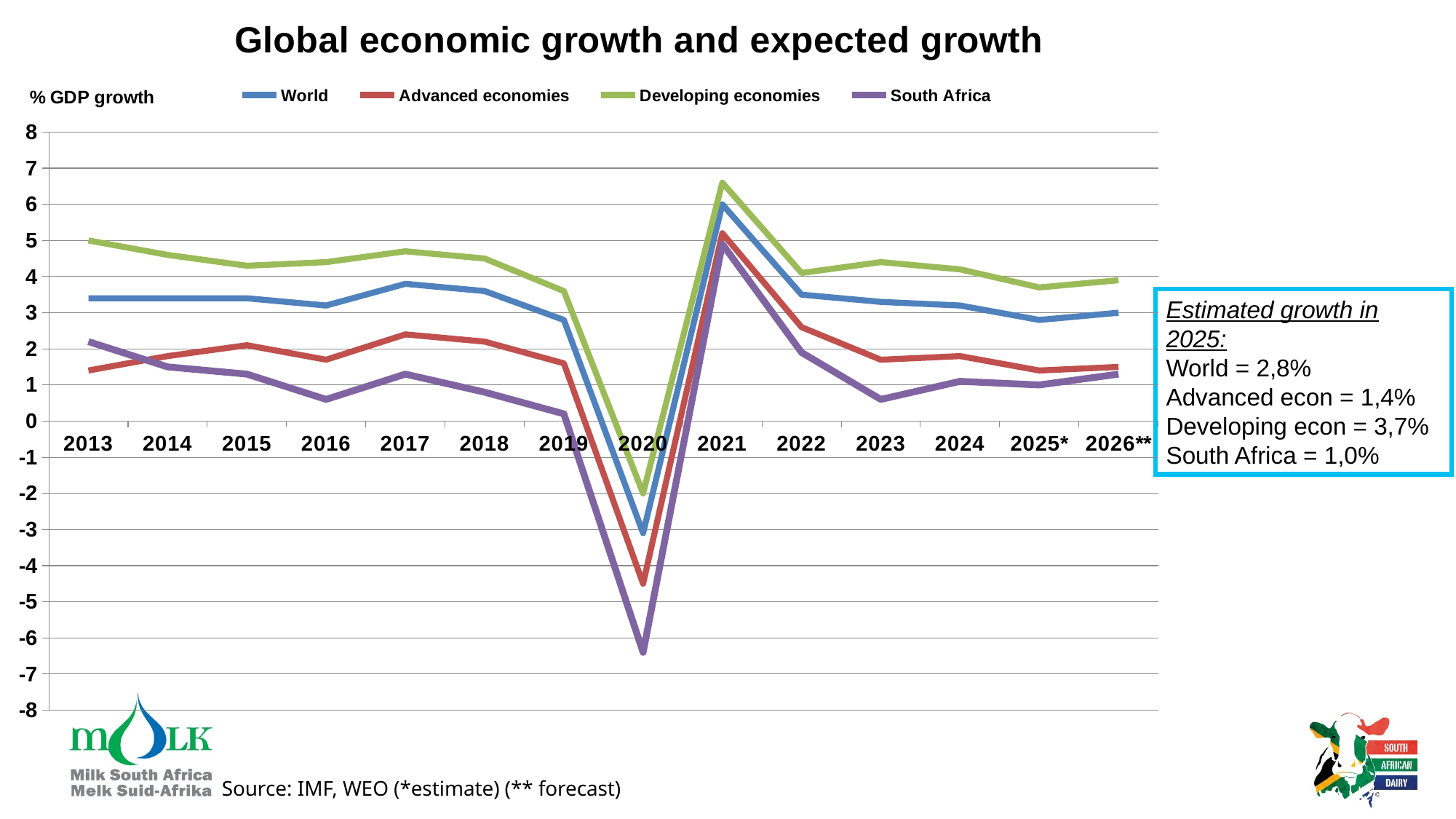
How many years are shown along the x axis? 14 What is the estimated growth for South Africa in 2025*? 1,0% What is the difference between the 2025 estimated growth for Developing economies and for World? 0,9% Is the value for World in 2021 greater or less than 5? greater What is the label on the y axis? % GDP growth In which year is the South Africa line at its lowest? 2020 What is the estimated growth for World in 2025*? 2,8% What kind of chart is shown on the slide? line chart What is the estimated growth for Developing economies in 2025*? 3,7% How many series does the legend list? 4 In 2021, which is larger: Developing economies or Advanced economies? Developing economies Is the value for South Africa in 2020 greater or less than -6? less